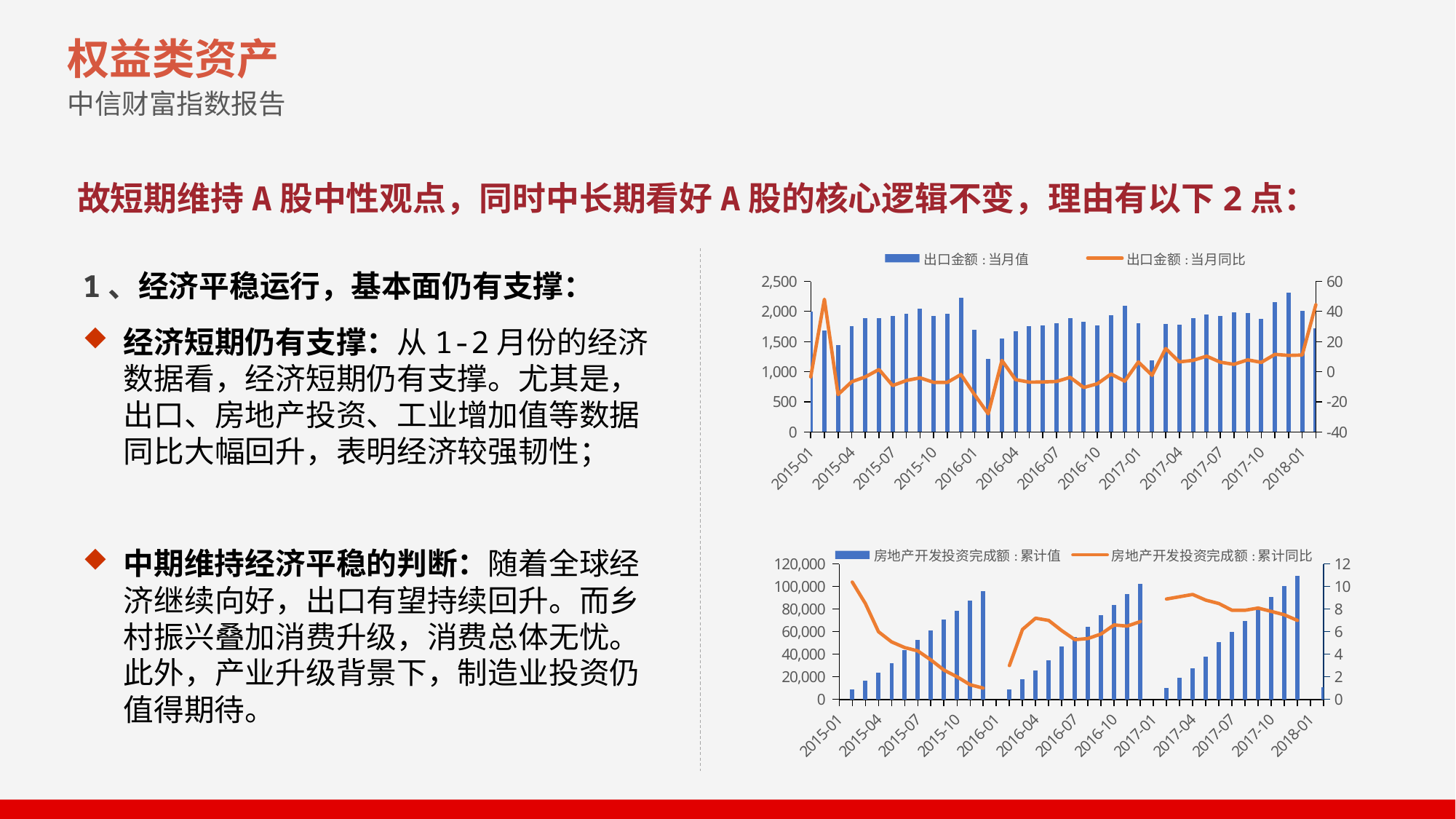
In the bottom chart, does the 房地产开发投资完成额:累计同比 line rise or fall over the course of 2015? fall How many series does the legend of the bottom chart list? 2 What kind of chart is the top chart on the slide? A combined bar and line chart In the top chart, is the value of the 出口金额:当月同比 line at 2018-01 greater or less than 40? less In the top chart, is the highest value of the 出口金额:当月同比 line greater or less than 40? greater What are the two legend entries of the top chart? 出口金额:当月值 and 出口金额:当月同比 In the bottom chart, is the tallest 房地产开发投资完成额:累计值 bar greater or less than 100,000? greater How many series does the legend of the top chart list? 2 What kind of chart is the bottom chart on the slide? A combined bar and line chart What is the maximum value shown on the right-hand axis of the bottom chart? 12